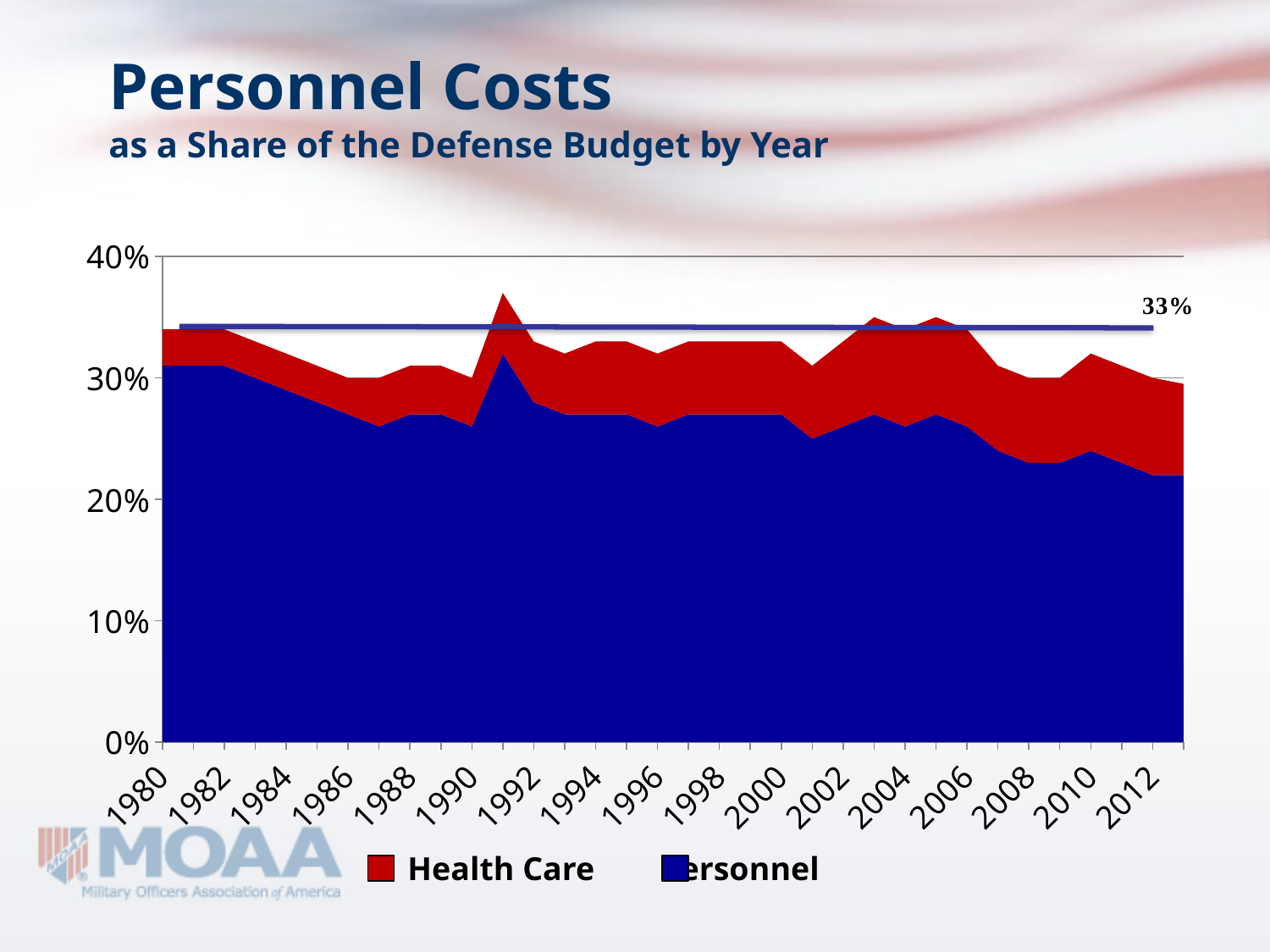
Is the Personnel value for 2012 greater or less than 20%? greater How many series does the legend list? 2 Does the Personnel share rise or fall overall from 1980 to 2012? Fall Is the combined Health Care and Personnel share for 1992 greater or less than 30%? greater Is the Personnel value for 2008 greater or less than 30%? less In 2012, which is larger, the Health Care share or the Personnel share? Personnel In which year does the combined Health Care and Personnel share reach its highest point? 1991 What is the first year shown on the x axis? 1980 What kind of chart is shown on the slide? Area chart What value is labelled on the horizontal reference line? 33% How many year labels are shown along the x axis? 17